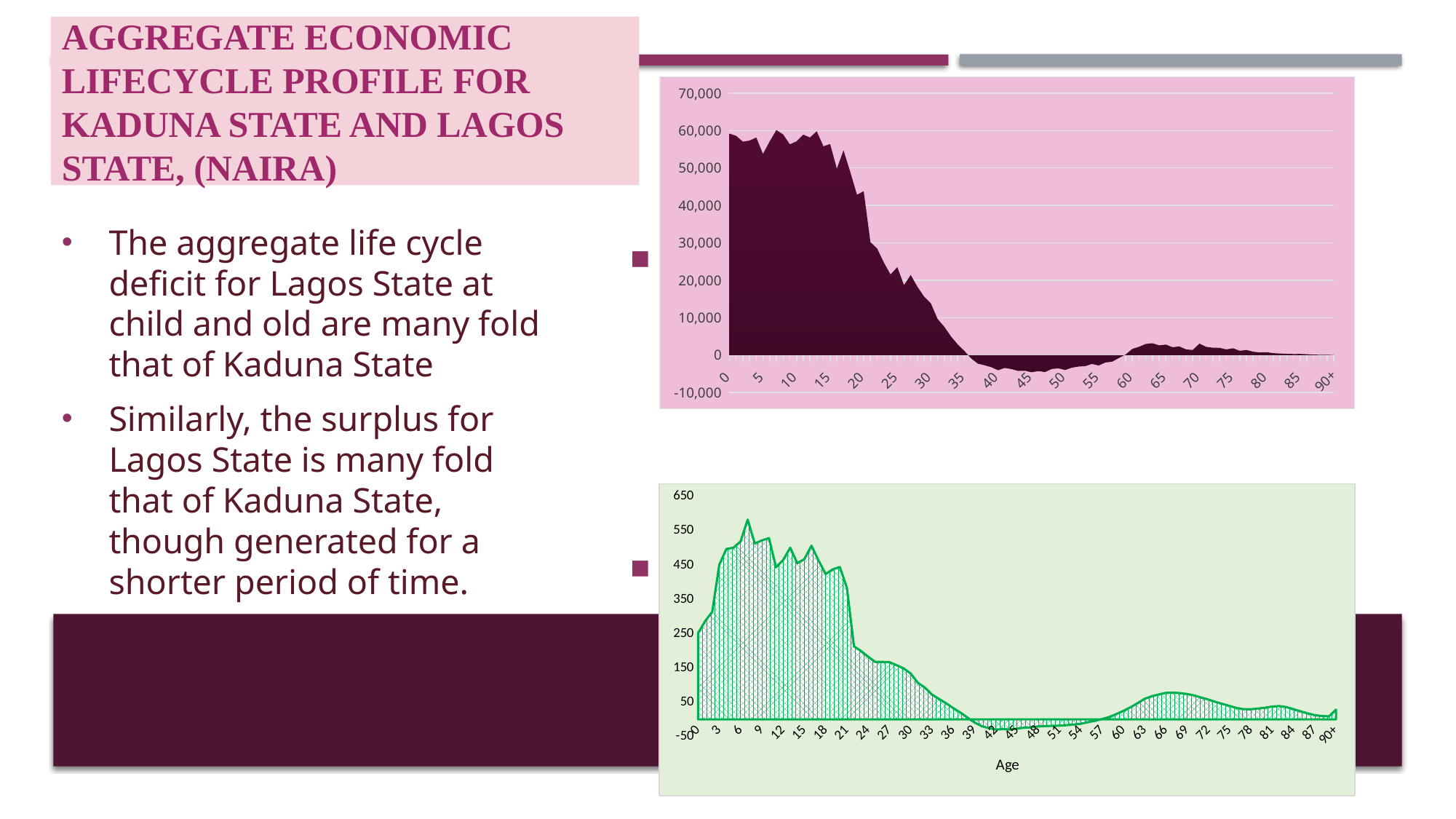
In the top chart, is the value at age 65 greater or less than 10,000? less In the bottom chart, is the value at age 66 greater or less than 50? greater In the bottom chart, is the value at age 9 greater or less than 450? greater In the top chart, do the values rise or fall between age 15 and age 35? fall In the bottom chart, do the values rise or fall between age 21 and age 39? fall What is the x-axis title of the bottom chart? Age What kind of chart is the top chart on the slide? area chart What kind of chart is the bottom chart on the slide? area chart